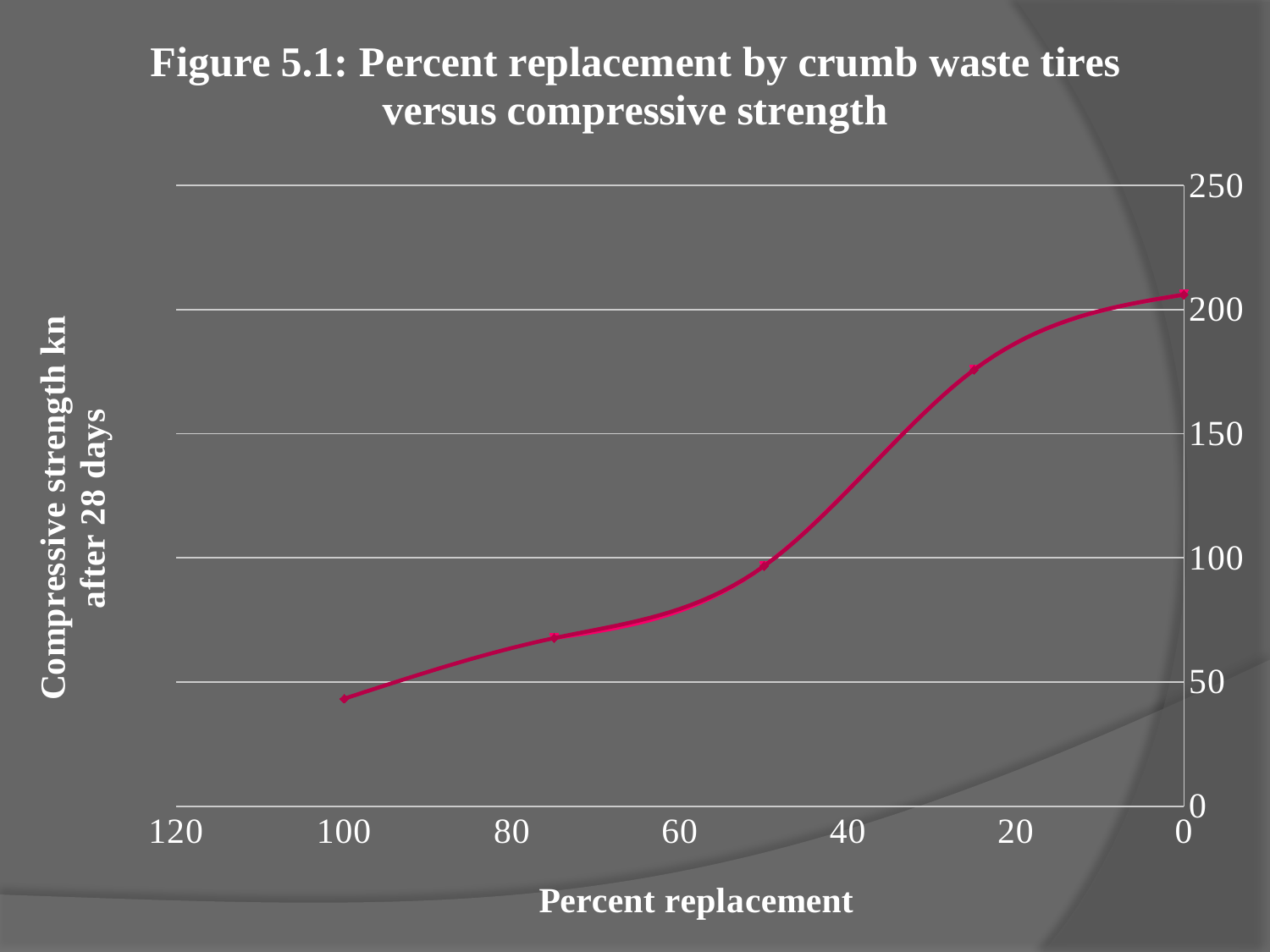
Is the compressive strength at 25 percent replacement greater or less than 150? greater Which has the larger compressive strength: 25 percent replacement or 50 percent replacement? 25 percent replacement At which percent replacement is the compressive strength lowest? 100 Is the compressive strength at 0 percent replacement greater or less than 150? greater Is the compressive strength at 75 percent replacement greater or less than 50? greater How many data points are plotted on the line? 5 At which percent replacement is the compressive strength highest? 0 What kind of chart is shown on the slide? line chart As percent replacement increases from 0 to 100, does the compressive strength rise or fall? fall What is the label of the vertical axis? Compressive strength kn after 28 days